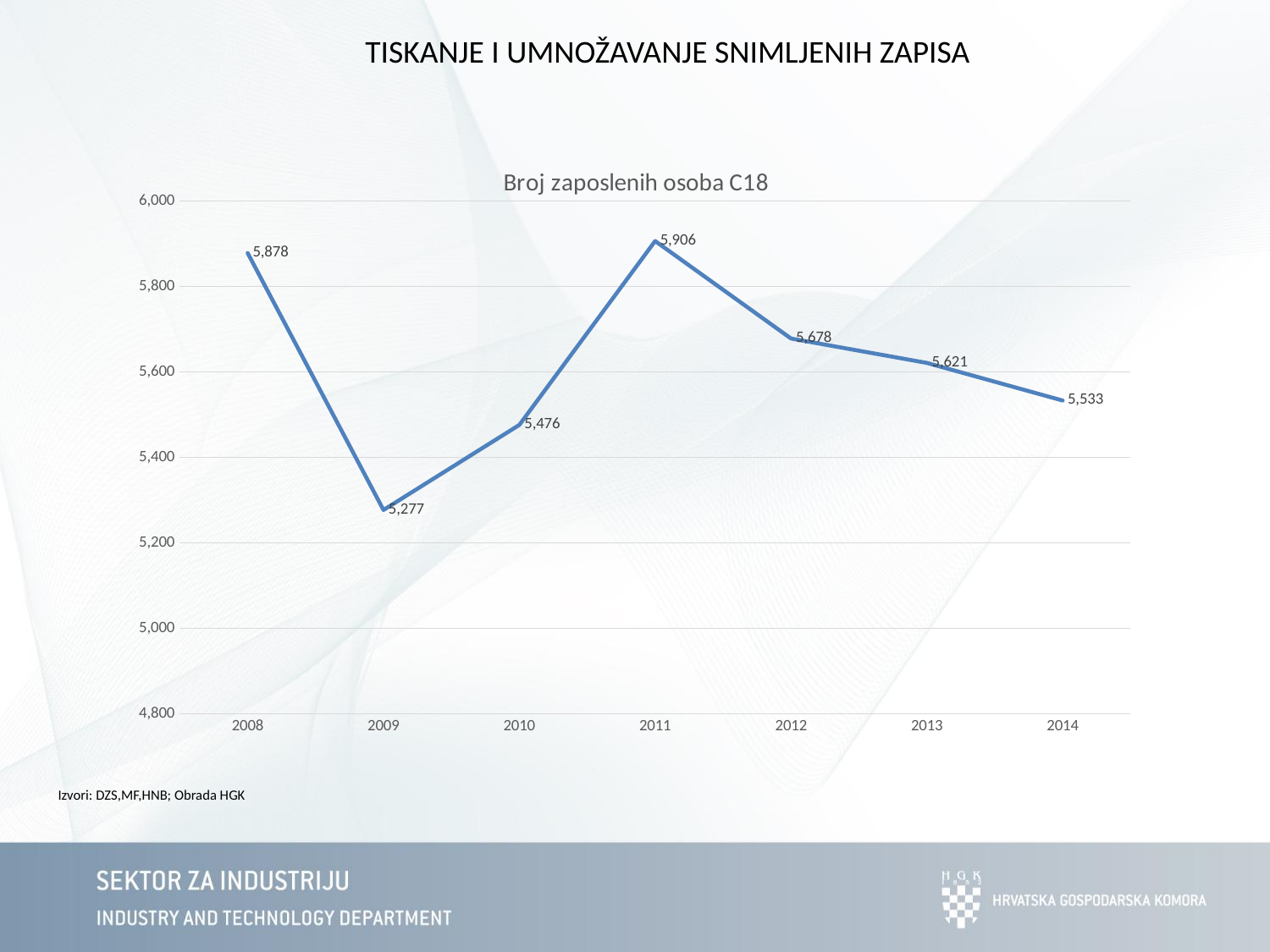
What is the value for 2011? 5,906 Which year has the lowest value? 2009 Which year has the highest value? 2011 What is the difference between the values for 2011 and 2009? 629 Which is larger, the value for 2010 or the value for 2012? 2012 What is the value for 2008? 5,878 How many years are plotted on the chart? 7 What kind of chart is shown? line chart What is the value for 2014? 5,533 What is the difference between the values for 2008 and 2014? 345 Do the values rise or fall from 2011 to 2014? fall Is the value for 2013 greater or less than 5,600? greater